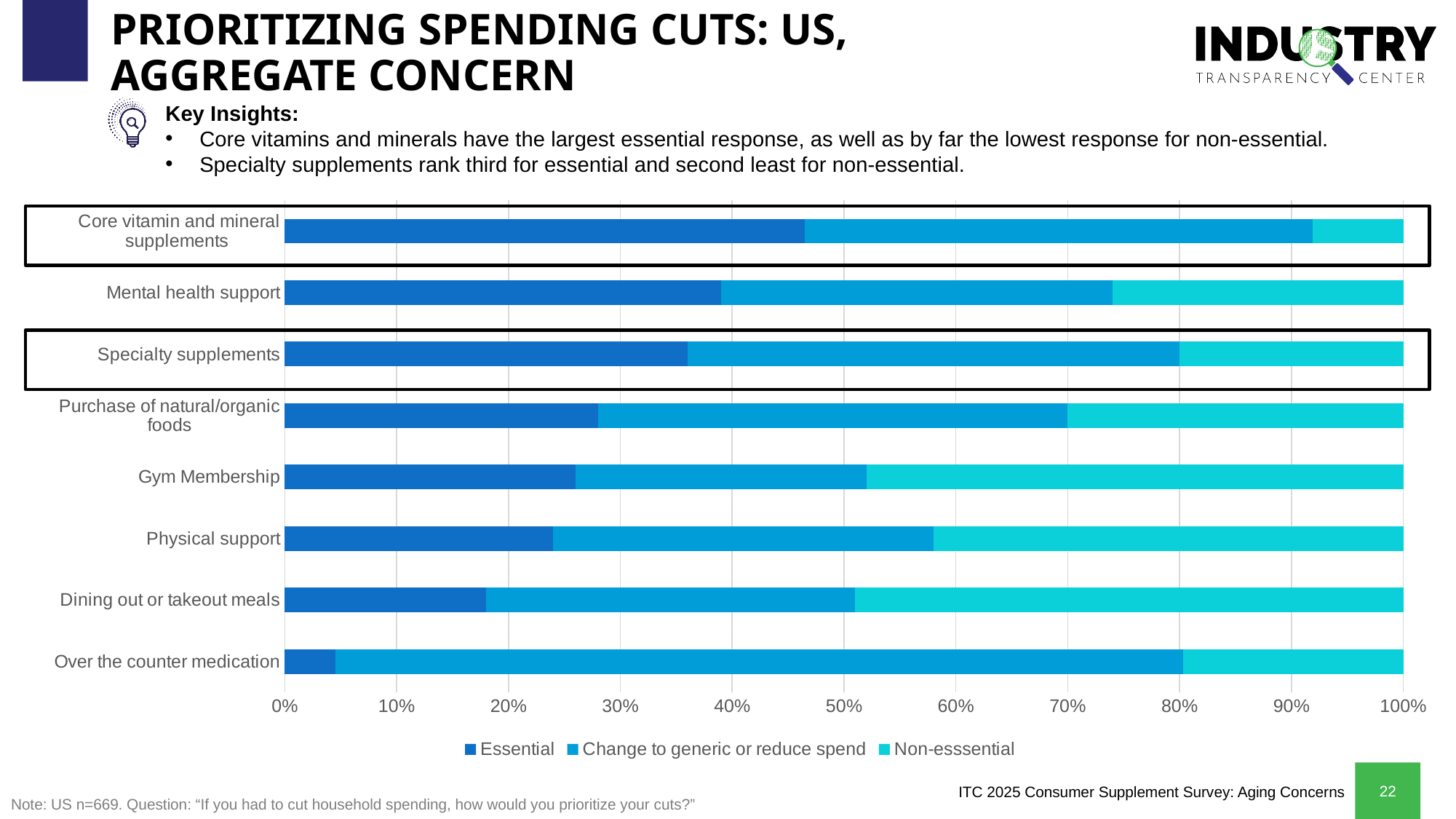
Is the Essential value for Over the counter medication greater or less than 10%? less Is the Essential value for Core vitamin and mineral supplements greater or less than 40%? greater Which category has the smallest Non-esssential share? Core vitamin and mineral supplements How many categories are plotted on the chart? 8 What are the three legend entries of the chart? Essential; Change to generic or reduce spend; Non-esssential Is the Essential value for Gym Membership greater or less than 20%? greater What does each stacked bar total on the x axis? 100% How many series does the legend list? 3 Which has a larger Essential share: Mental health support or Gym Membership? Mental health support Which category has the smallest Essential share? Over the counter medication What kind of chart is shown on the slide? Stacked bar chart Which category has the largest Essential share? Core vitamin and mineral supplements